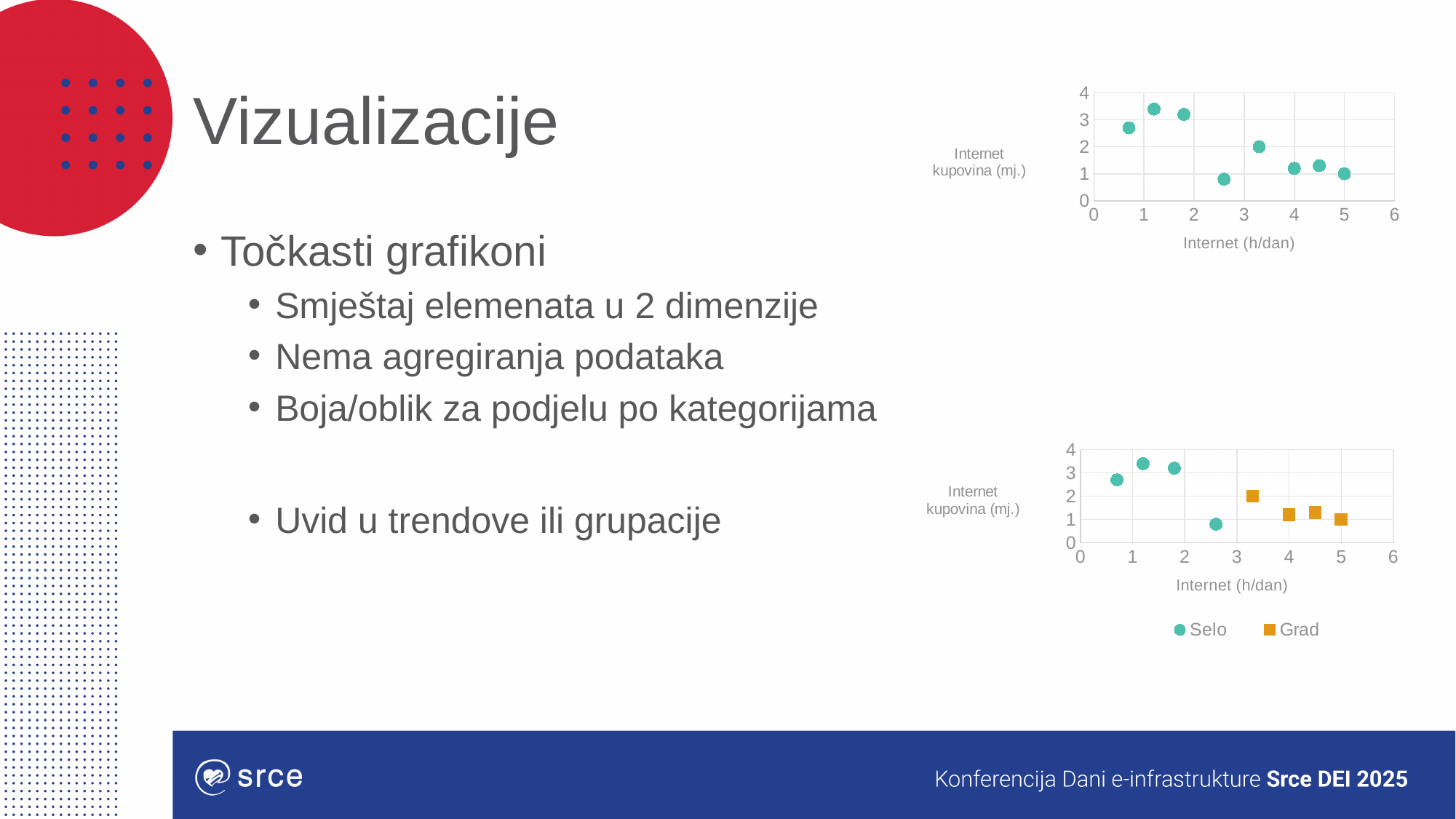
What is the x-axis title of the top chart? Internet (h/dan) In the bottom chart, which series has the points with the higher Internet kupovina values, Selo or Grad? Selo How many series does the legend of the bottom chart list? 2 How many data points are plotted in the top chart? 8 What kind of chart is the top chart on the slide? scatter chart In the bottom chart, how many points belong to the Selo series? 4 What kind of chart is the bottom chart on the slide? scatter chart In the top chart, do the y values generally rise or fall as the x value increases? fall In the bottom chart, what are the two series named in the legend? Selo and Grad In the bottom chart, is the y value of the Selo point at about x = 1.2 greater or less than 3? greater In the bottom chart, how many points belong to the Grad series? 4 In the top chart, is the y value of the point at x = 5 greater or less than 2? less